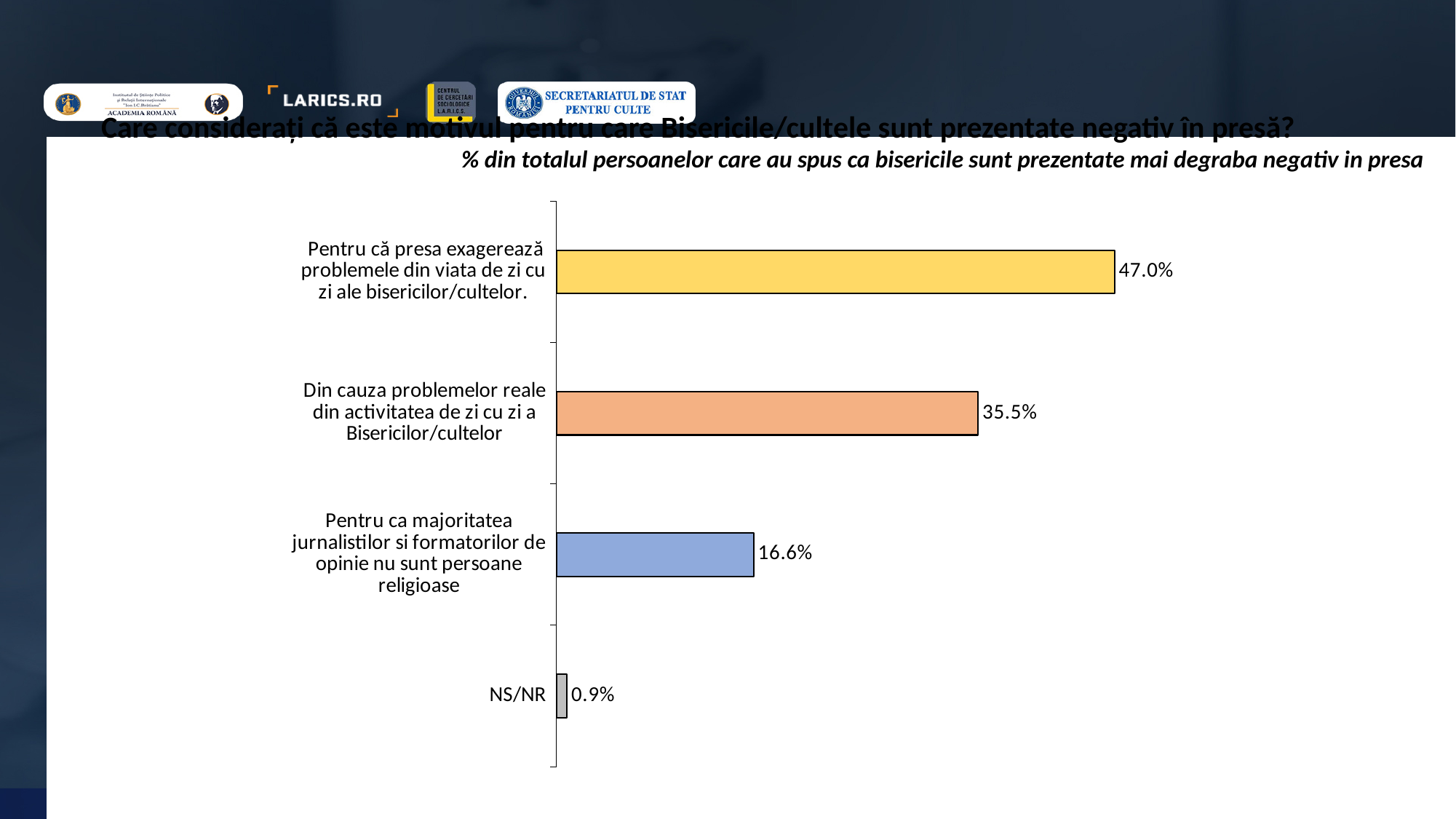
What percentage is shown for 'Din cauza problemelor reale din activitatea de zi cu zi a Bisericilor/cultelor'? 35.5% How many categories are shown in the chart? 4 What colour is the bar for 'Din cauza problemelor reale din activitatea de zi cu zi a Bisericilor/cultelor'? Orange What percentage is shown for the category 'Pentru că presa exagerează problemele din viata de zi cu zi ale bisericilor/cultelor.'? 47.0% Which category has the lowest value? NS/NR What is the difference between the value for 'Pentru că presa exagerează problemele din viata de zi cu zi ale bisericilor/cultelor.' and the value for 'Din cauza problemelor reale din activitatea de zi cu zi a Bisericilor/cultelor'? 11.5% Which is larger: the value for 'Pentru ca majoritatea jurnalistilor si formatorilor de opinie nu sunt persoane religioase' or the value for NS/NR? Pentru ca majoritatea jurnalistilor si formatorilor de opinie nu sunt persoane religioase What percentage is shown for 'Pentru ca majoritatea jurnalistilor si formatorilor de opinie nu sunt persoane religioase'? 16.6% Which category has the highest value? Pentru că presa exagerează problemele din viata de zi cu zi ale bisericilor/cultelor. What percentage is shown for NS/NR? 0.9% What is the difference between the value for 'Din cauza problemelor reale din activitatea de zi cu zi a Bisericilor/cultelor' and the value for 'Pentru ca majoritatea jurnalistilor si formatorilor de opinie nu sunt persoane religioase'? 18.9% What kind of chart is shown on the slide? Bar chart